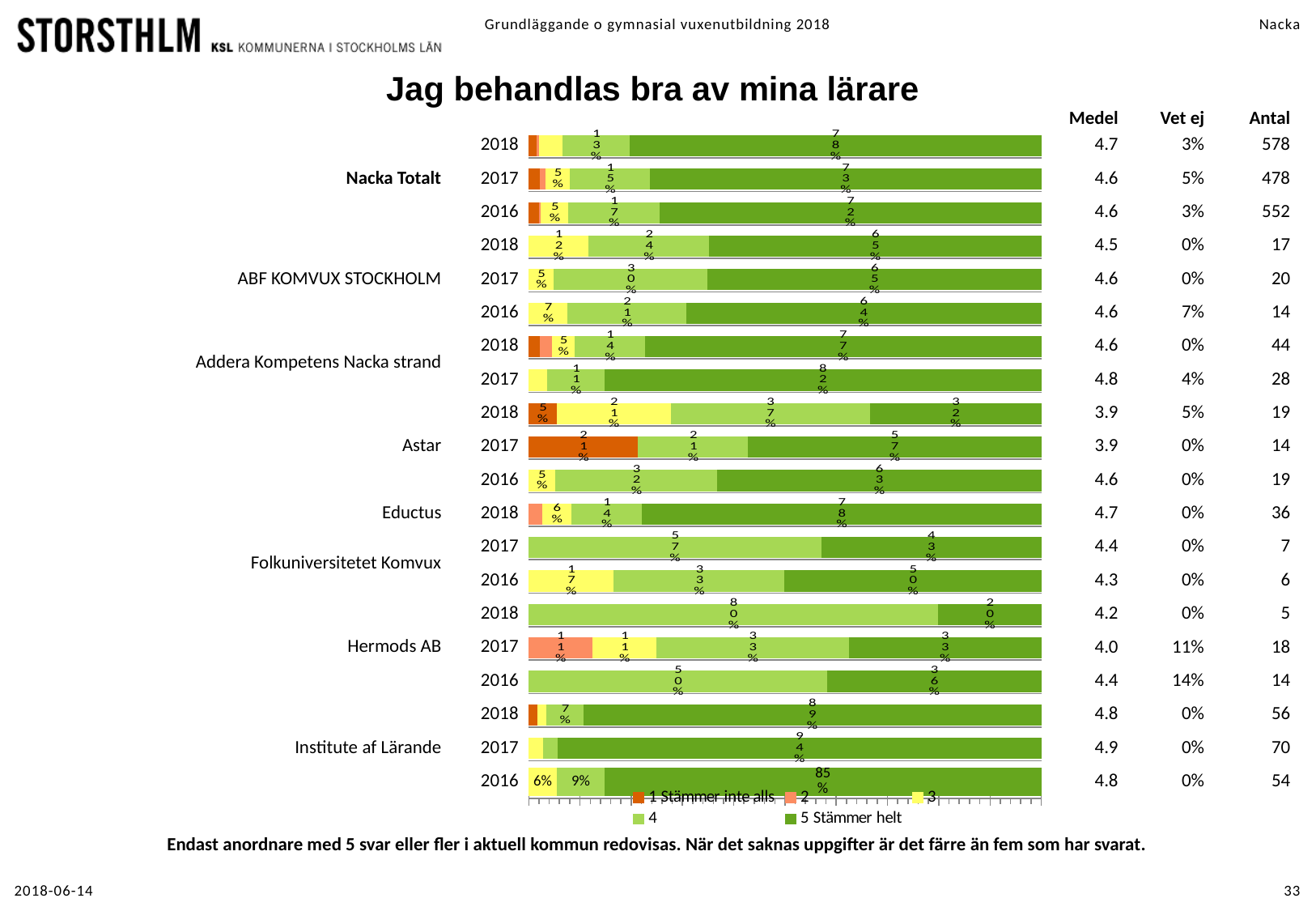
What is the share of category '4' for Hermods AB in 2018? 80% For Institute af Lärande, which year has the highest share of '5 Stämmer helt'? 2017 For Institute af Lärande in 2016, what is the difference between the '5 Stämmer helt' share and the '3' share? 79 percentage points What is the share of '5 Stämmer helt' for Nacka Totalt in 2018? 78% What is the legend label for the darkest green series? 5 Stämmer helt What is the share of category '4' for Folkuniversitetet Komvux in 2017? 57% What kind of chart is shown on the slide? Stacked bar chart Which has a larger share of '5 Stämmer helt': Astar 2017 or Institute af Lärande 2017? Institute af Lärande 2017 What is the share of '5 Stämmer helt' for Institute af Lärande in 2017? 94% How many series does the chart legend list? 5 What is the share of '5 Stämmer helt' for Institute af Lärande in 2016? 85%